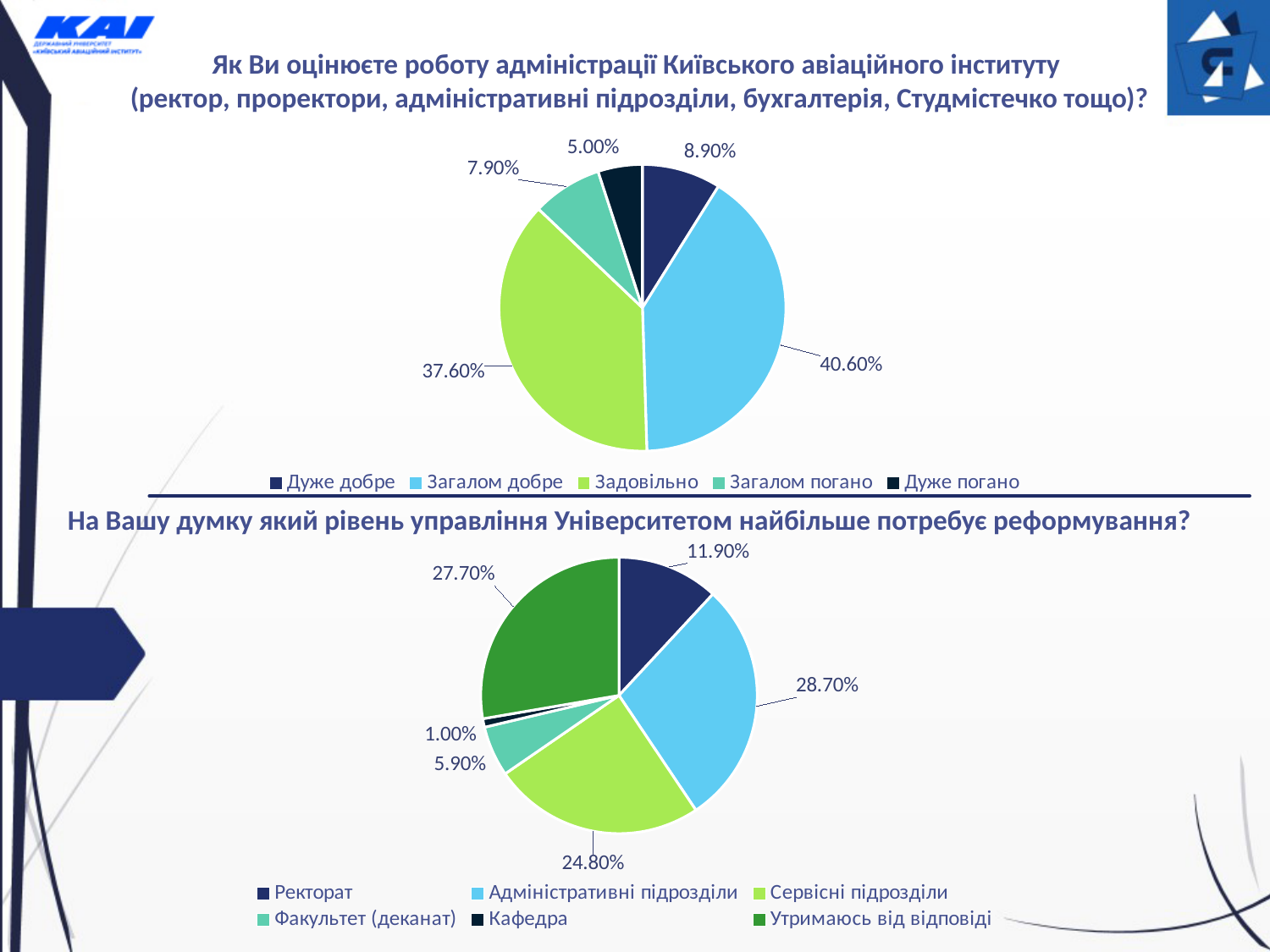
In the bottom pie chart, what share of respondents chose "Кафедра"? 1.00% In the bottom pie chart, which category has the smallest share? Кафедра In the top pie chart, what share of respondents answered "Дуже погано"? 5.00% How many categories does the legend of the bottom pie chart list? 6 In the top pie chart, which category has the smallest share? Дуже погано In the bottom pie chart, what share of respondents chose "Адміністративні підрозділи"? 28.70% What type of chart is used for the bottom chart on the slide? Pie chart In the top pie chart, what share of respondents answered "Загалом добре"? 40.60% In the top pie chart, which category has the largest share? Загалом добре In the bottom pie chart, which is larger: "Сервісні підрозділи" or "Утримаюсь від відповіді"? Утримаюсь від відповіді In the top pie chart, what is the difference between the shares for "Загалом добре" and "Задовільно"? 3.00% How many categories does the top pie chart show? 5